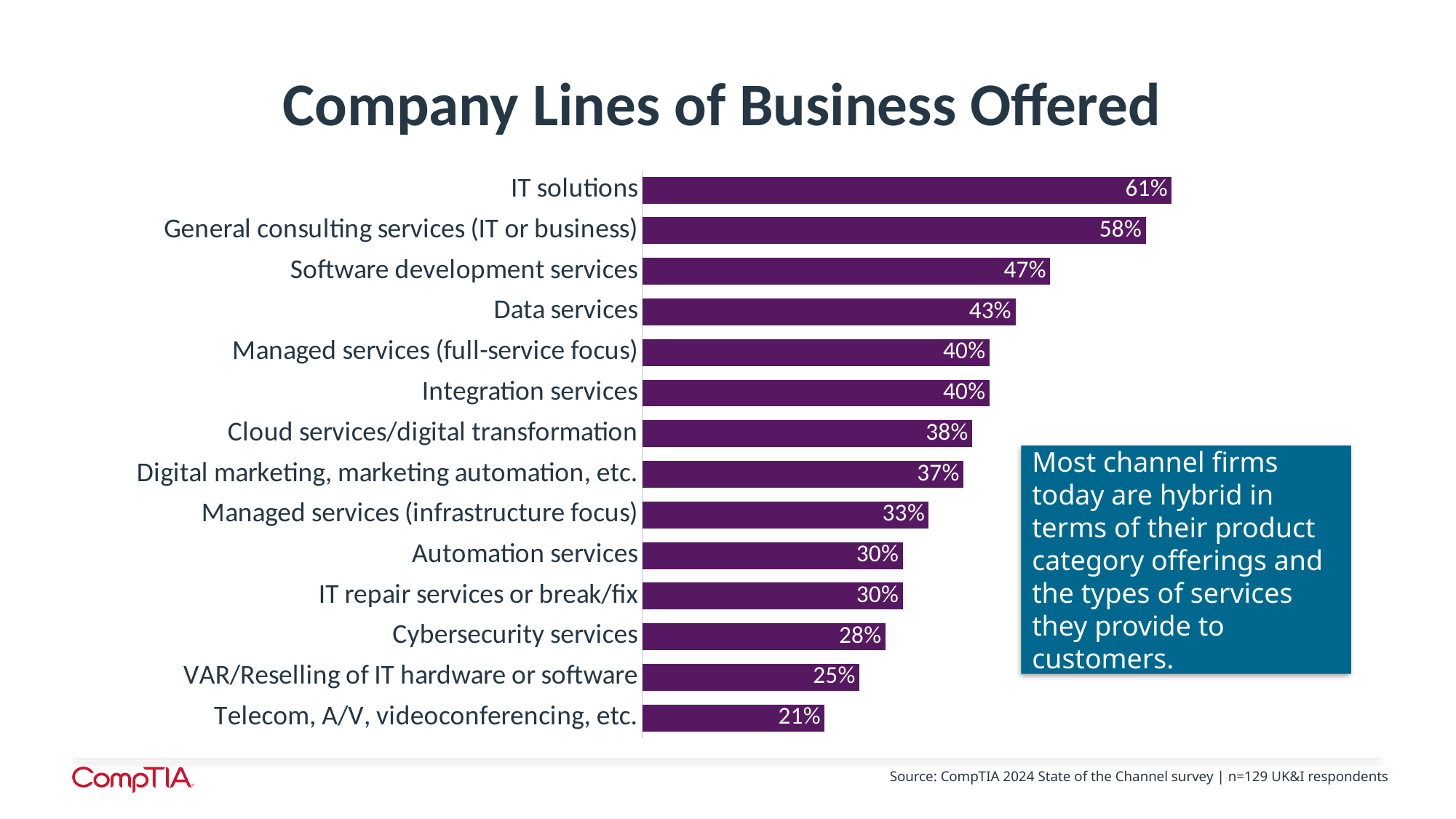
What is the value for Cybersecurity services? 28% What is the difference between Software development services and VAR/Reselling of IT hardware or software? 22 percentage points What percentage of respondents offer IT solutions? 61% What kind of chart is shown on the slide? Bar chart How many lines of business are shown in the chart? 14 Which line of business has the lowest value? Telecom, A/V, videoconferencing, etc. What is the difference between IT solutions and General consulting services (IT or business)? 3 percentage points Which is larger: Cloud services/digital transformation or Managed services (infrastructure focus)? Cloud services/digital transformation Which line of business has the highest value? IT solutions What colour are the bars in the chart? Purple What is the title of the chart? Company Lines of Business Offered What is the value for Data services? 43%